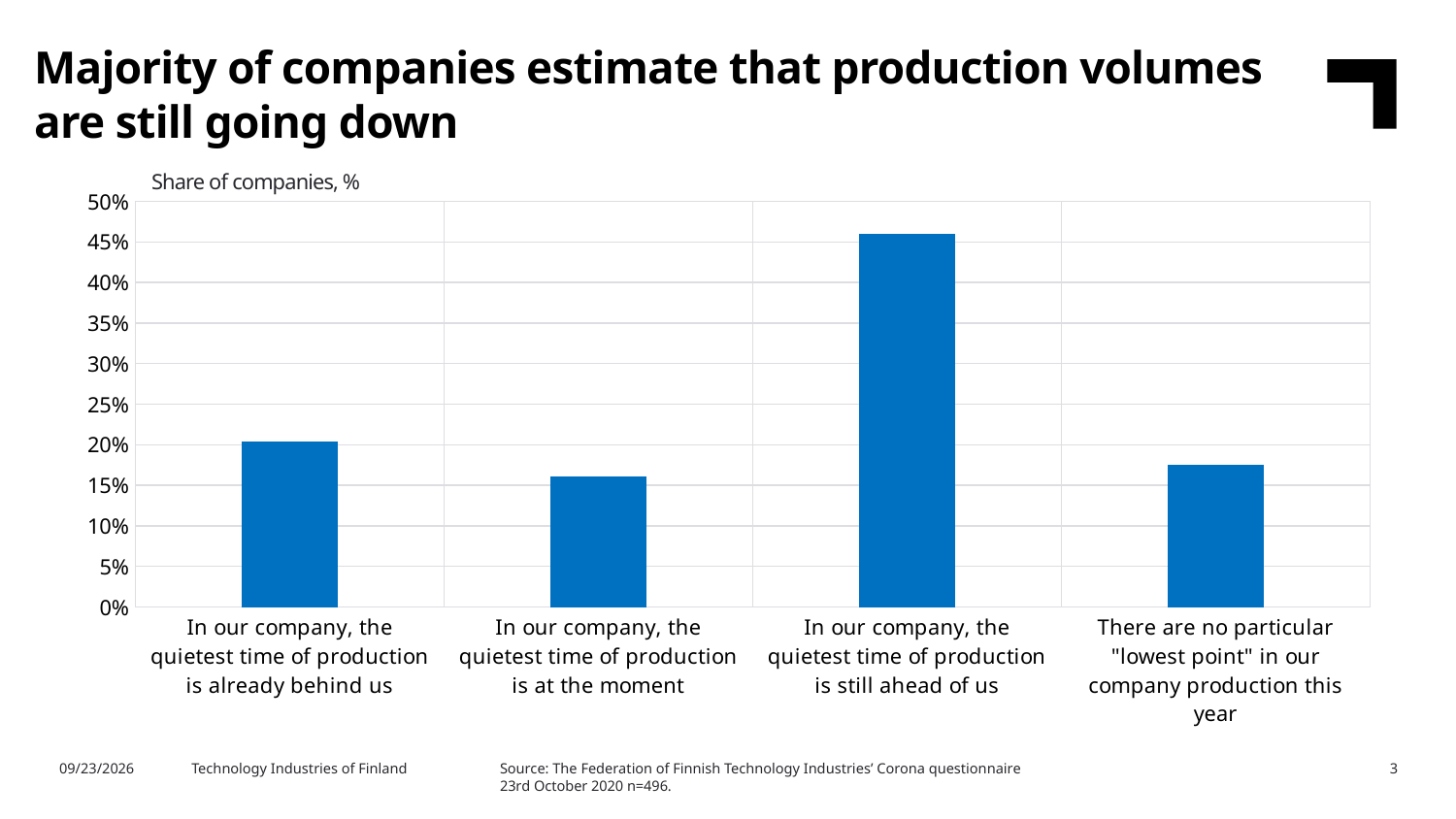
What kind of chart is shown on the slide? Bar chart Is the value for "In our company, the quietest time of production is still ahead of us" greater or less than 50%? less Is the value for "In our company, the quietest time of production is still ahead of us" greater or less than 40%? greater Which is larger: the share for "the quietest time of production is already behind us" or for "the quietest time of production is at the moment"? The quietest time of production is already behind us Is the value for "There are no particular 'lowest point' in our company production this year" greater or less than 20%? less What is the label shown above the vertical axis of the chart? Share of companies, % How many categories are shown on the x axis of the chart? 4 Which is larger: the share for "the quietest time of production is already behind us" or for "the quietest time of production is still ahead of us"? The quietest time of production is still ahead of us What is the maximum value shown on the vertical axis of the chart? 50% Which category has the highest share of companies? In our company, the quietest time of production is still ahead of us